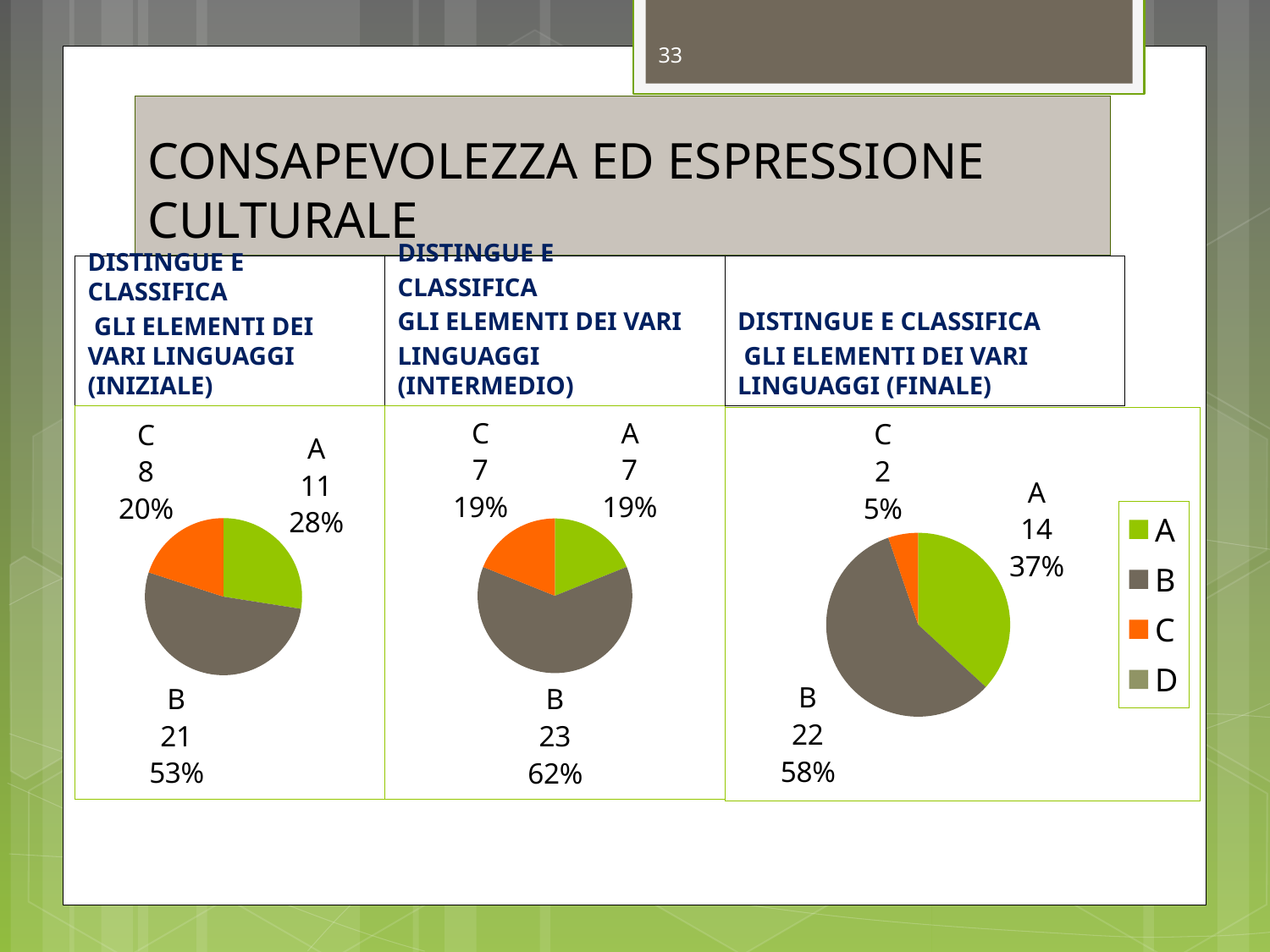
In the middle pie chart (INTERMEDIO), what is the value for C? 7 In the left pie chart (INIZIALE), what share of the pie does A represent? 28% In the right pie chart (FINALE), what share of the pie does B represent? 58% In the right pie chart (FINALE), which category has the smallest slice? C How many entries does the legend on the right of the slide list? 4 In the right pie chart (FINALE), which is larger, the value for A or the value for C? A In the middle pie chart (INTERMEDIO), which category has the largest slice? B In the right pie chart (FINALE), what is the value for A? 14 How many slices are shown in the middle pie chart (INTERMEDIO)? 3 In the left pie chart (INIZIALE), what is the value for B? 21 What type of chart is used in the left panel (INIZIALE)? Pie chart In the left pie chart (INIZIALE), what is the difference between the values for B and A? 10